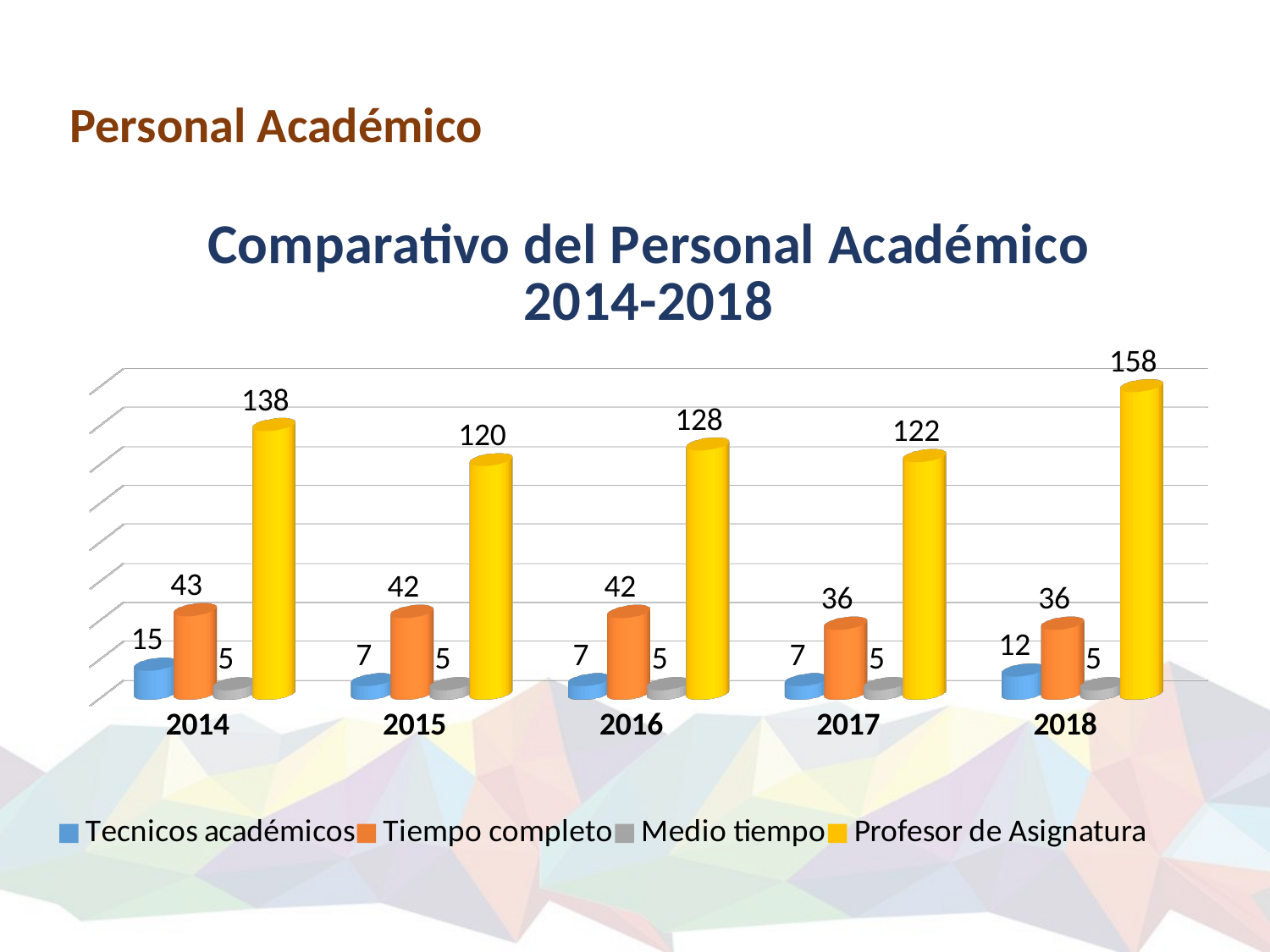
What is the value for Tecnicos académicos in 2018? 12 In which year is the value for Profesor de Asignatura lowest? 2015 In which year is the value for Profesor de Asignatura highest? 2018 Which is larger, the Tiempo completo value for 2015 or for 2017? 2015 What is the difference between the Profesor de Asignatura values for 2018 and 2014? 20 What is the value for Tiempo completo in 2014? 43 What is the value for Medio tiempo in 2016? 5 What is the value for Profesor de Asignatura in 2018? 158 What kind of chart is shown? Bar chart What is the title of the chart? Comparativo del Personal Académico 2014-2018 How many series does the legend list? 4 How many years are shown on the x axis? 5